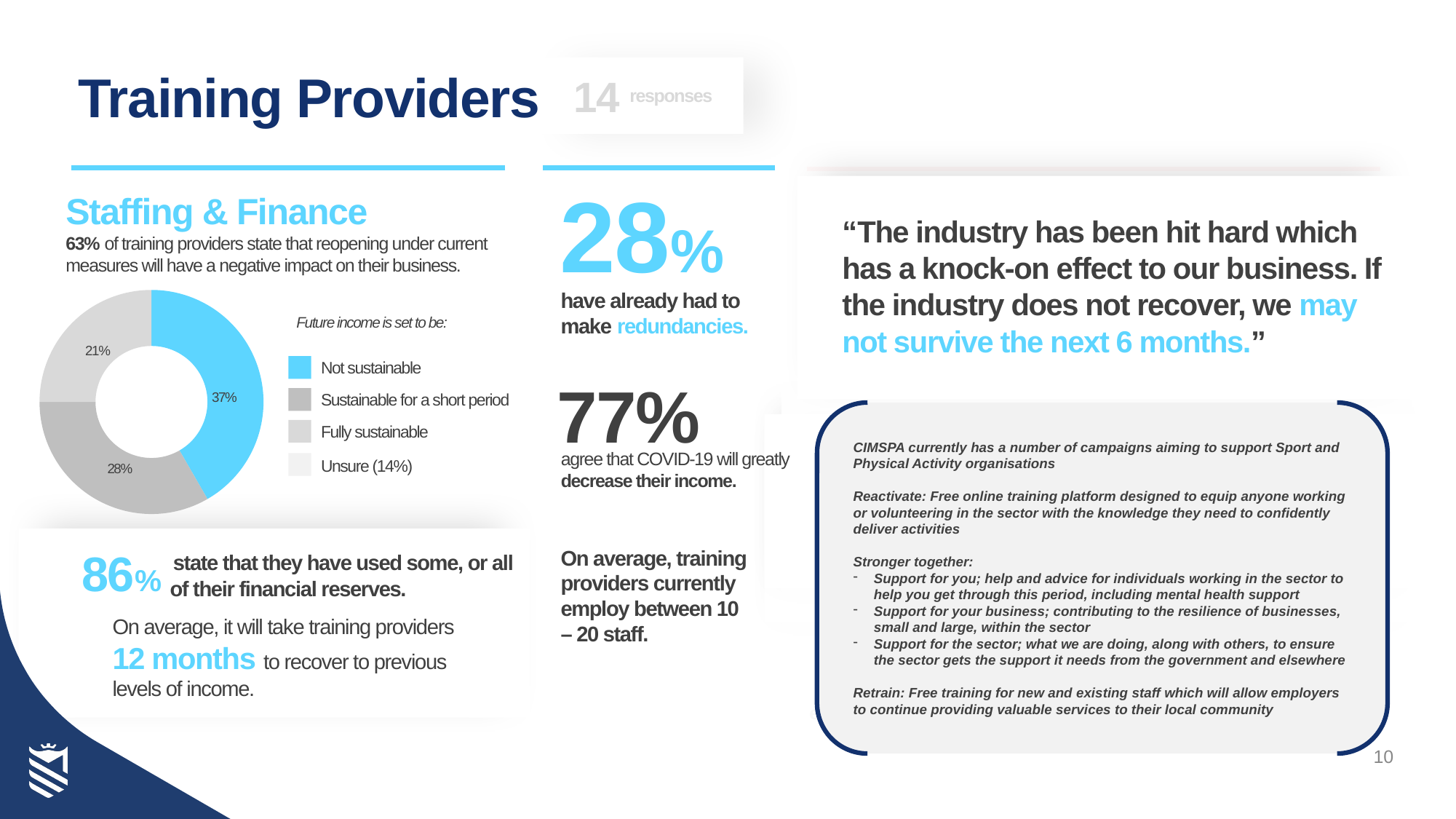
In the 'Future income is set to be' chart, what percentage of training providers say their future income is 'Not sustainable'? 37% Which category has the smallest share in the 'Future income is set to be' chart? Unsure In the 'Future income is set to be' chart, how many percentage points larger is 'Not sustainable' than 'Fully sustainable'? 16 percentage points Which category has the largest share in the 'Future income is set to be' chart? Not sustainable How many categories does the legend of the 'Future income is set to be' chart list? 4 In the 'Future income is set to be' chart, what percentage is shown for 'Fully sustainable'? 21% In the 'Future income is set to be' chart, what percentage of respondents are 'Unsure'? 14% What kind of chart is shown under the 'Staffing & Finance' heading? Doughnut (pie) chart In the 'Future income is set to be' chart, which is larger: 'Sustainable for a short period' or 'Fully sustainable'? Sustainable for a short period In the 'Future income is set to be' chart, what colour is the 'Not sustainable' slice? Blue In the 'Future income is set to be' chart, what percentage is shown for 'Sustainable for a short period'? 28% In the 'Future income is set to be' chart, what is the combined share of 'Not sustainable' and 'Sustainable for a short period'? 65%